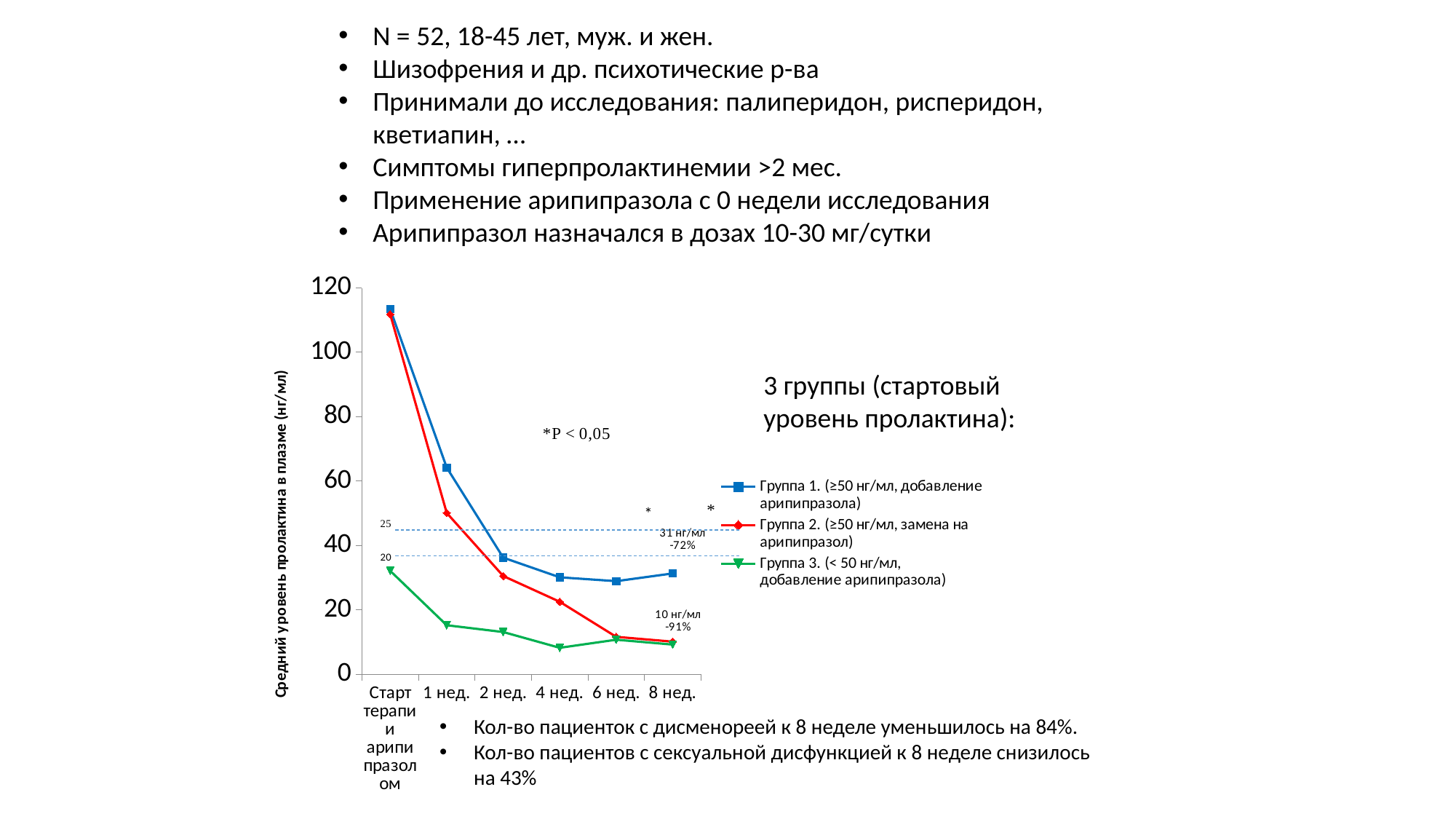
What is the difference between the labelled 8 нед. values of Группа 1 and Группа 2? 21 нг/мл How many time points are plotted along the x axis of the chart? 6 What is the title of the vertical axis of the chart? Средний уровень пролактина в плазме (нг/мл) Which series has the lowest value at the start of therapy (Старт терапии арипипразолом)? Группа 3 At 8 нед., which series has the larger value: Группа 1 or Группа 2? Группа 1 What is the prolactin level for Группа 2 at 8 нед. according to the data label? 10 нг/мл How many series does the chart legend list? 3 Is the value for Группа 1 at the start of therapy greater or less than 100? greater What is the prolactin level for Группа 1 at 8 нед. according to the data label? 31 нг/мл What kind of chart is shown on the slide? line chart What percentage change is labelled for Группа 2 at 8 нед.? -91% Do the values for Группа 2 rise or fall from the start of therapy to 8 нед.? fall